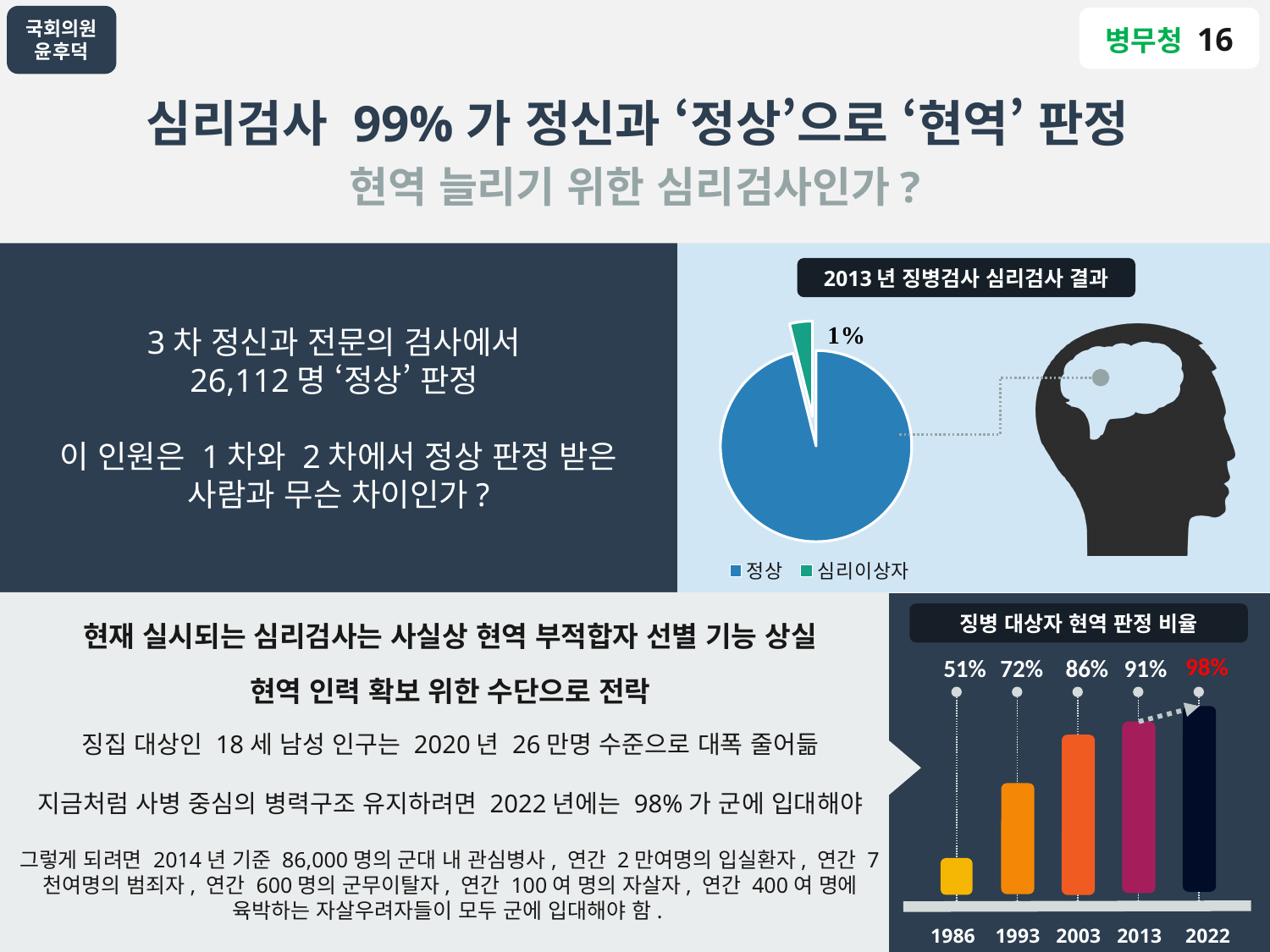
In the chart titled '징병 대상자 현역 판정 비율', what is the difference between the values for 2013 and 1993? 19% In the chart titled '2013년 징병검사 심리검사 결과', how many entries does the legend list? 2 In the chart titled '징병 대상자 현역 판정 비율', how many years are shown on the x axis? 5 In the chart titled '징병 대상자 현역 판정 비율', what is the value for 2022? 98% In the chart titled '2013년 징병검사 심리검사 결과', what share of the pie is '심리이상자'? 1% In the chart titled '징병 대상자 현역 판정 비율', which year has the lowest value? 1986 In the chart titled '징병 대상자 현역 판정 비율', what is the value for 2003? 86% What kind of chart is the chart titled '징병 대상자 현역 판정 비율'? bar chart In the chart titled '징병 대상자 현역 판정 비율', do the values rise or fall from 1986 to 2022? rise In the chart titled '징병 대상자 현역 판정 비율', which is larger, the value for 1993 or the value for 2003? 2003 In the chart titled '징병 대상자 현역 판정 비율', which year has the highest value? 2022 In the chart titled '징병 대상자 현역 판정 비율', what is the value for 1986? 51%